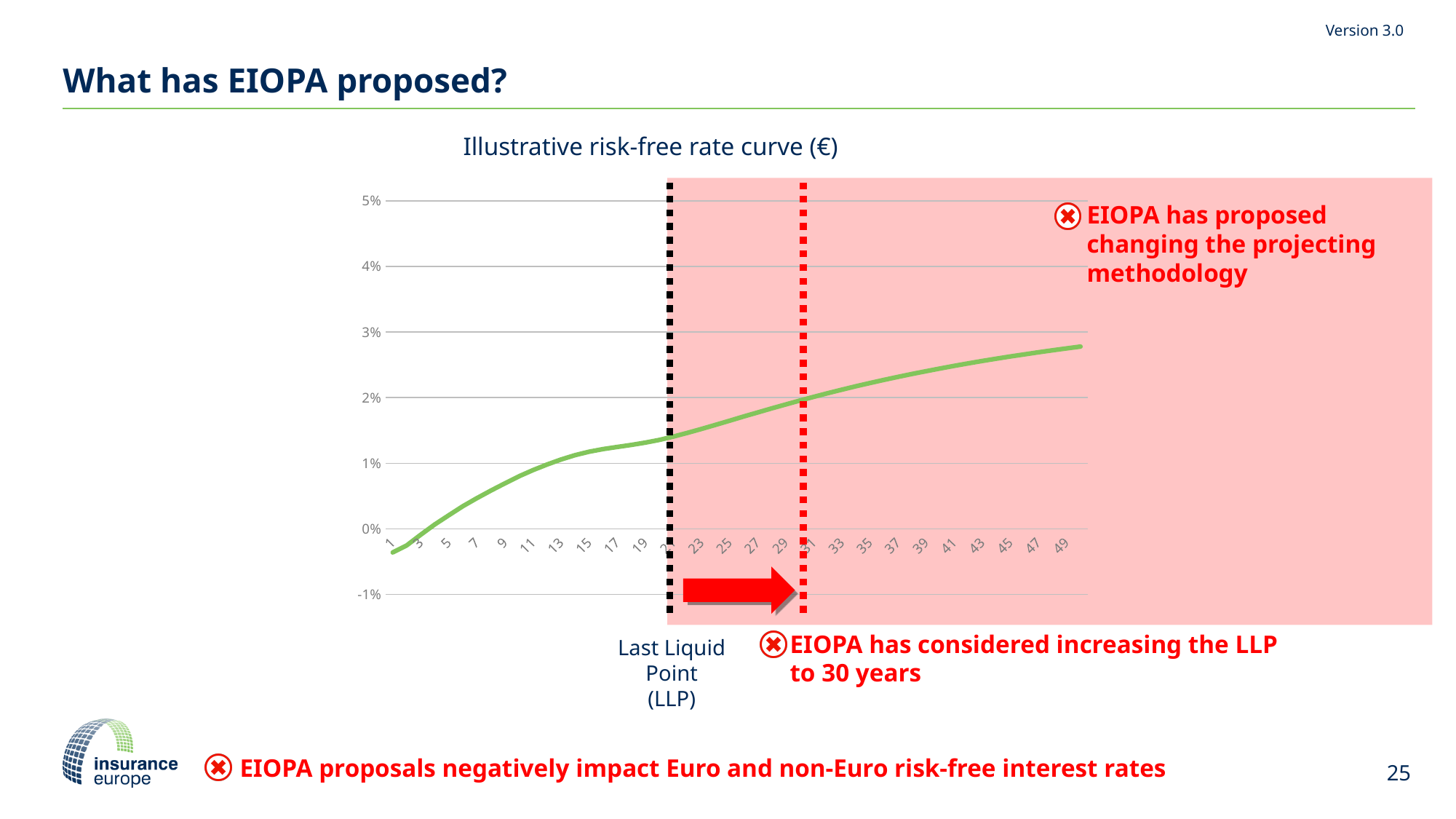
Is the value of the curve at x = 5 greater or less than 1%? less Is the value of the curve at x = 29 greater or less than 1%? greater Does the risk-free rate curve rise or fall as the x-axis values increase from 1 to 49? Rise Is the value of the curve at x = 1 greater or less than 0%? less How many tick labels are shown on the x-axis? 25 What is the highest value labelled on the y-axis? 5% What kind of chart is shown on the slide? Line chart At which x-axis value does the curve reach its lowest point? 1 What is the title of the chart? Illustrative risk-free rate curve (€)